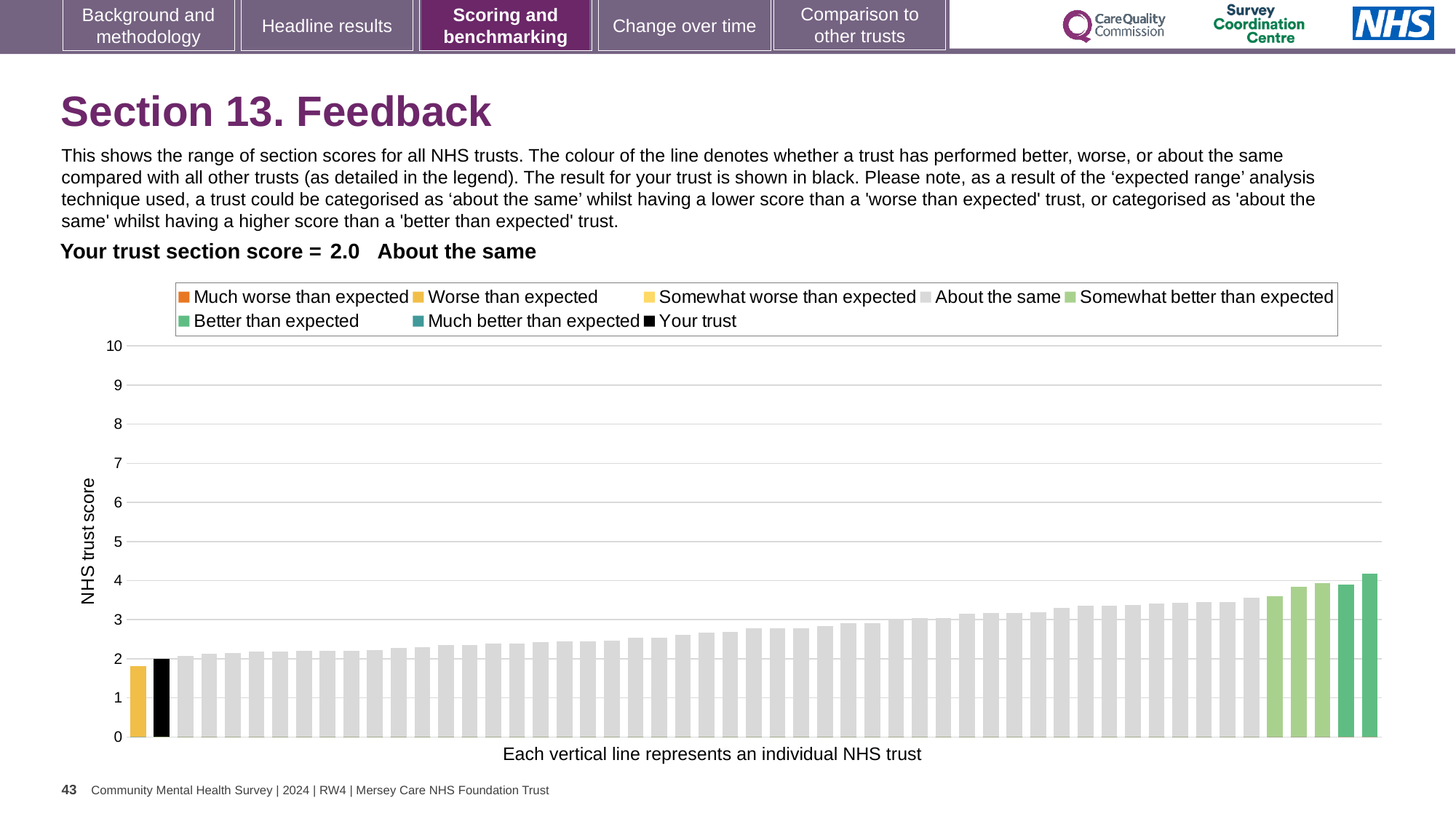
Is the value for your trust greater or less than 3? less What kind of chart is shown on the slide? bar chart Is the value of the lowest bar in the chart greater or less than 2? less How many entries does the chart legend list? 8 What colour is the bar representing your trust? black Which performance category is your trust placed in for Section 13. Feedback? About the same Do the bar values rise or fall from left to right along the x axis? rise What is the section score for your trust shown on the slide? 2.0 What is the highest value shown on the y axis? 10 What is the label on the y axis of the chart? NHS trust score Is the value of the highest bar in the chart greater or less than 5? less